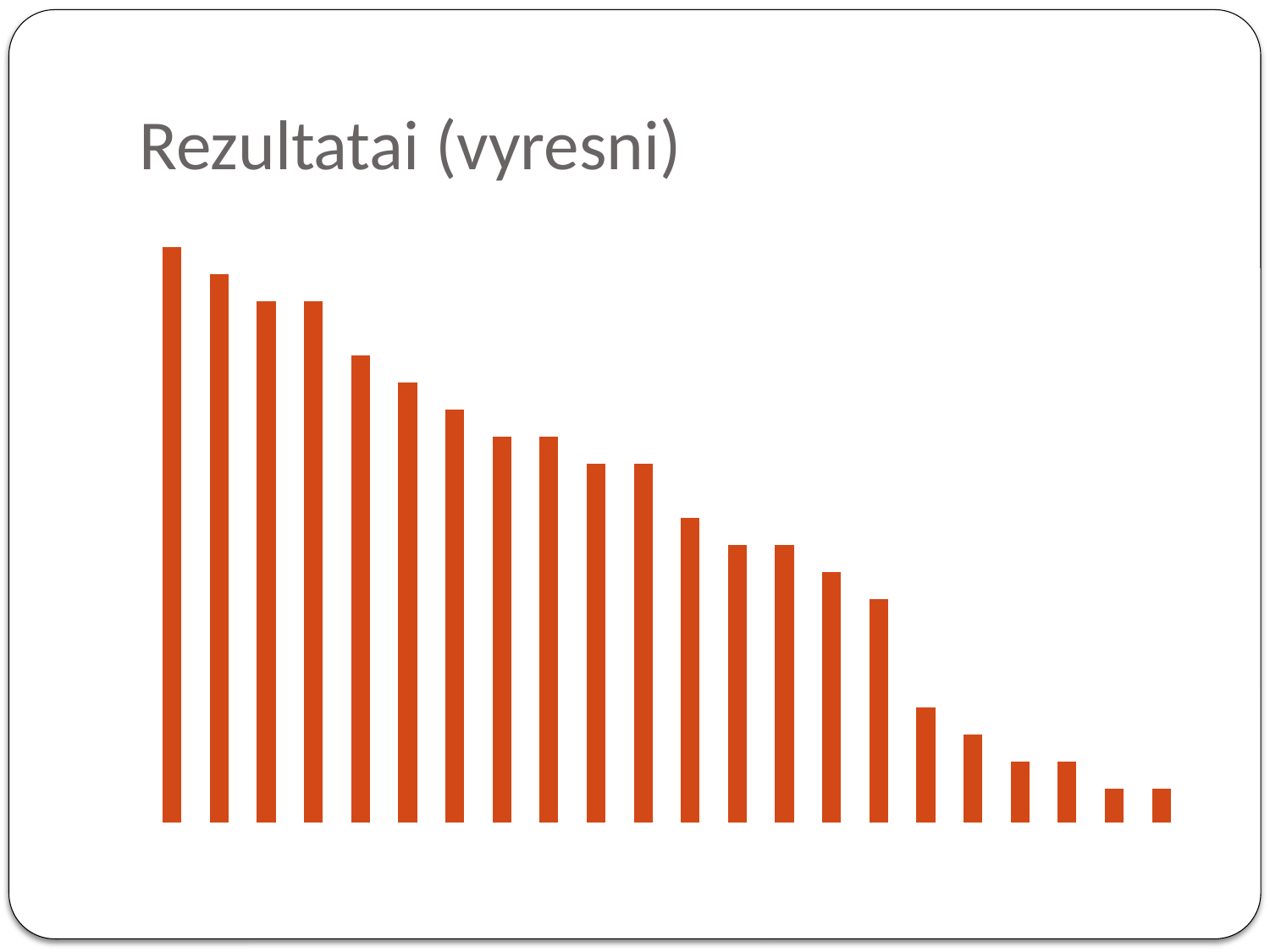
What colour are the bars in the chart? orange What is the title of the slide containing the chart? Rezultatai (vyresni) Which is larger: the value of the first bar or the value of the last bar? the first bar Do the bar values rise or fall from left to right across the chart? fall What kind of chart is shown on the slide? bar chart How many bars does the chart contain? 22 Which bar is the tallest: the leftmost bar or the rightmost bar? the leftmost bar Is the shortest bar at the left end or the right end of the chart? right end Is the tallest bar at the left end or the right end of the chart? left end